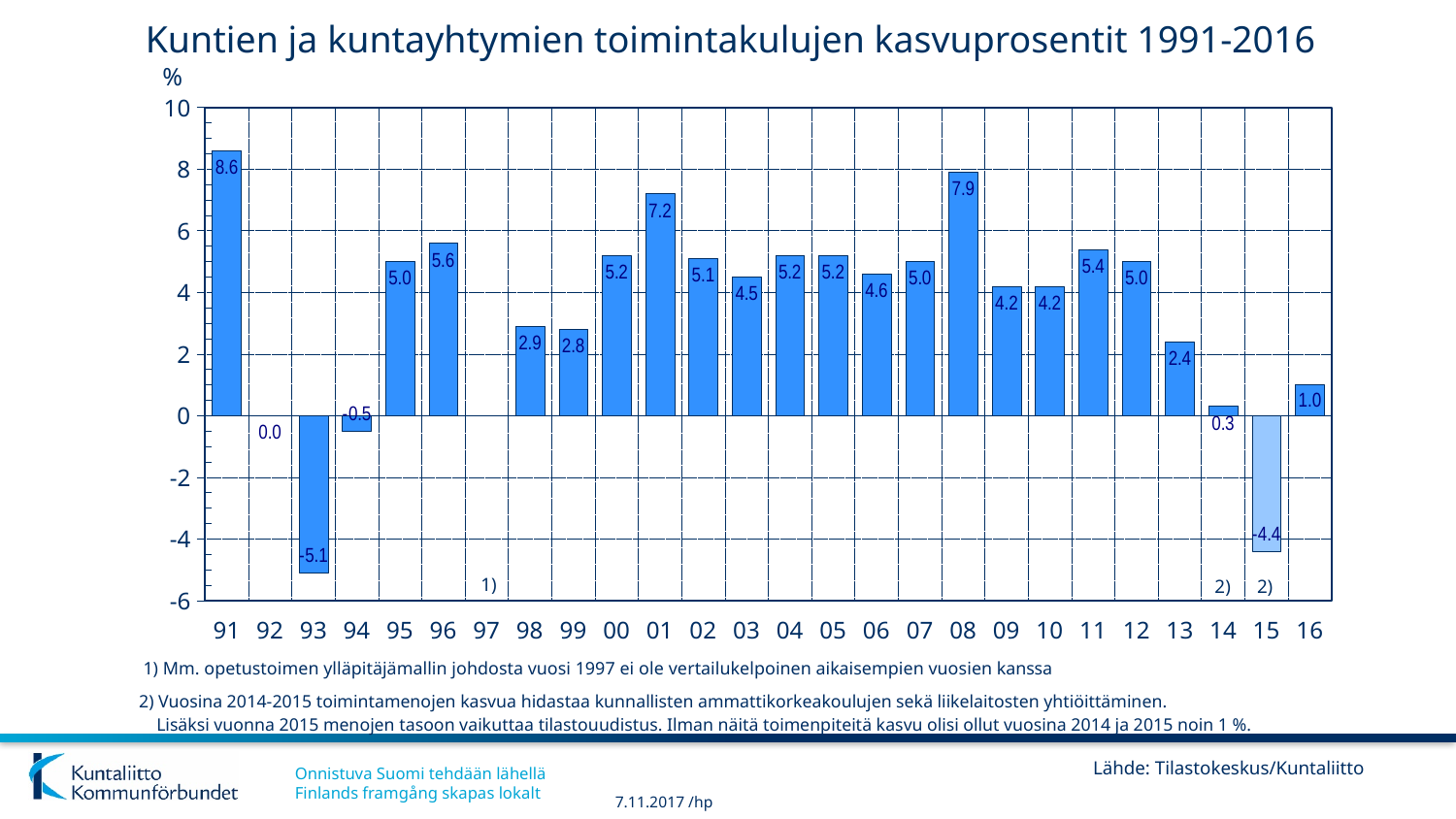
What is the value for 91? 8.6 Which year has the lowest value? 93 Which is larger, the value for 95 or the value for 96? 96 Which year has the highest value? 91 What is the value for 08? 7.9 What is the difference between the values for 08 and 01? 0.7 How many years are shown on the x axis? 26 What is the value for 15? -4.4 Is the value for 15 greater or less than -4? less What is the value for 13? 2.4 Do the values rise or fall from 11 to 14? fall What kind of chart is shown on the slide? bar chart